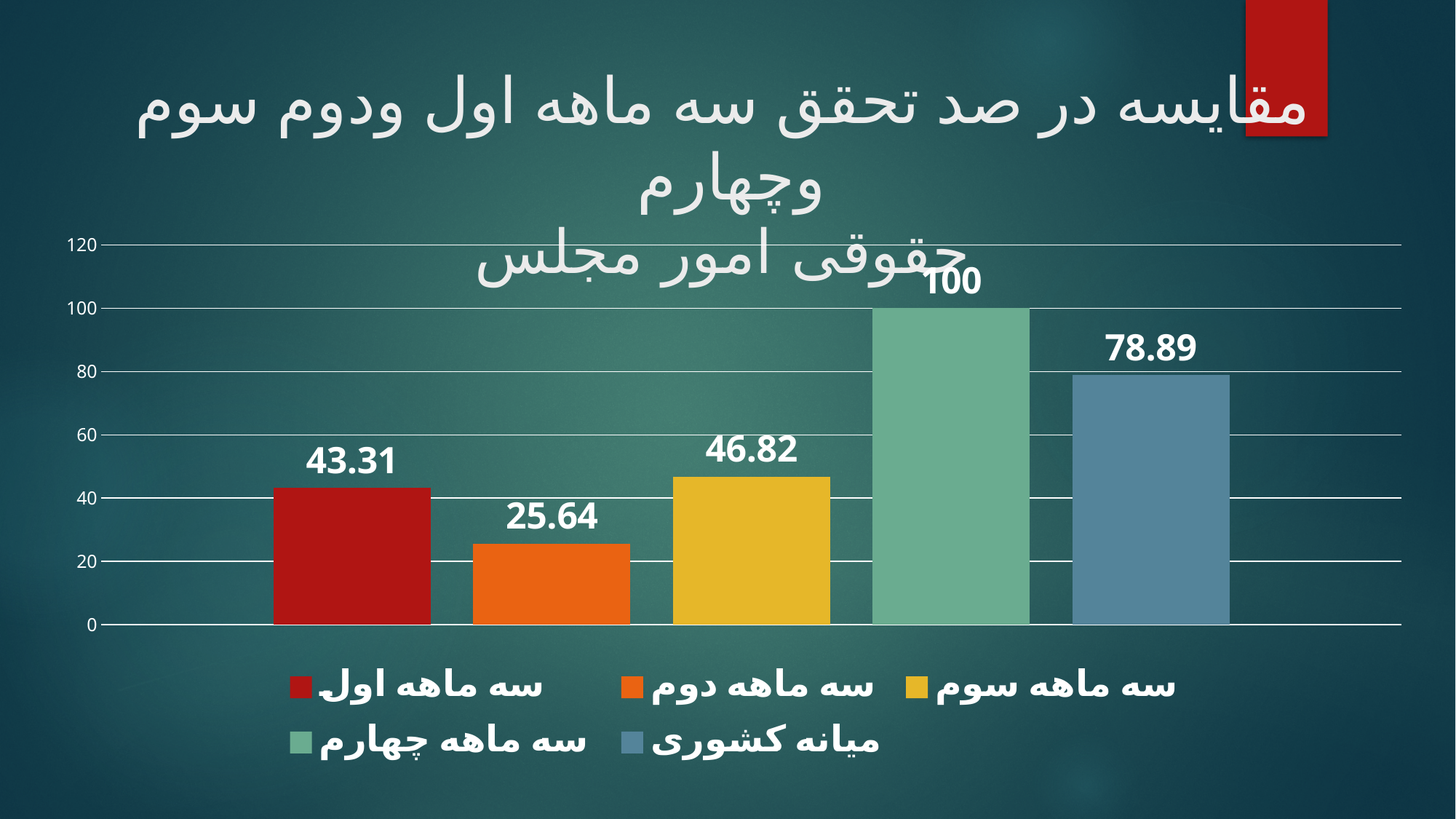
What is the value for سه ماهه دوم? 25.64 What is the difference between the values for سه ماهه چهارم and میانه کشوری? 21.11 Which category has the highest value? سه ماهه چهارم What is the value for میانه کشوری? 78.89 How many bars are shown in the chart? 5 What kind of chart is shown on the slide? bar chart Which is larger, the value for سه ماهه اول or سه ماهه سوم? سه ماهه سوم Which category has the lowest value? سه ماهه دوم What is the value for سه ماهه سوم? 46.82 What is the value for سه ماهه چهارم? 100 How many entries does the legend list? 5 What is the value for سه ماهه اول? 43.31